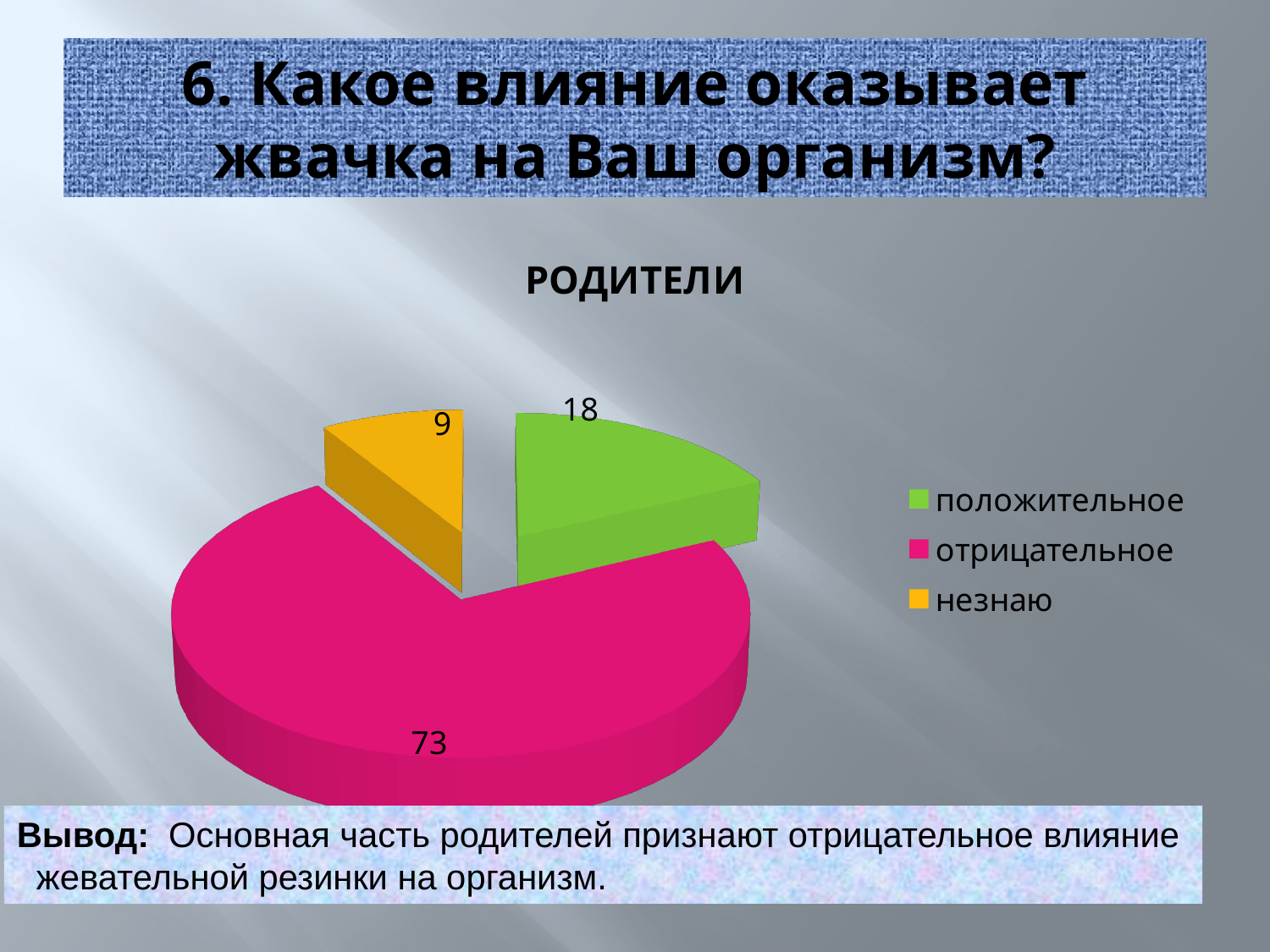
What is the value for положительное? 18 What type of chart is shown on the slide? pie chart Which category has the largest slice? отрицательное Which is larger, положительное or незнаю? положительное What is the title of the chart? РОДИТЕЛИ What is the total of all slices in the pie chart? 100 Which category has the smallest slice? незнаю What is the difference between the values for отрицательное and положительное? 55 What share of the pie does отрицательное represent? 73% How many categories does the pie chart have? 3 What is the value for отрицательное? 73 What is the value for незнаю? 9